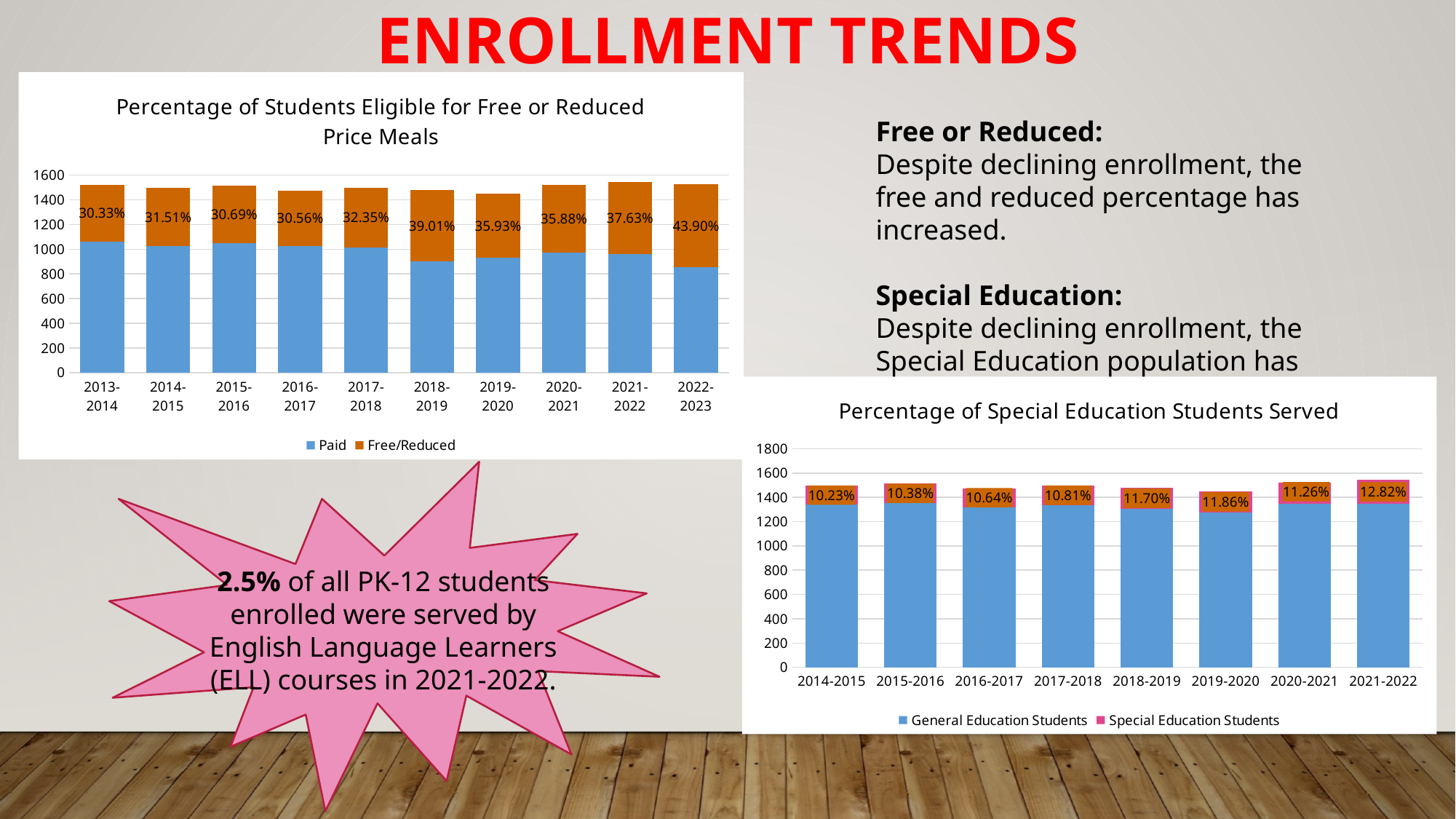
In the chart titled "Percentage of Students Eligible for Free or Reduced Price Meals", which school year has the lowest percentage label? 2013-2014 In the chart titled "Percentage of Students Eligible for Free or Reduced Price Meals", which school year has the highest percentage label? 2022-2023 In the chart titled "Percentage of Students Eligible for Free or Reduced Price Meals", is the total height of the 2021-2022 bar greater or less than 1400? greater In the chart titled "Percentage of Students Eligible for Free or Reduced Price Meals", what percentage label is shown for 2022-2023? 43.90% In the chart titled "Percentage of Special Education Students Served", what percentage label is shown for 2018-2019? 11.70% In the chart titled "Percentage of Students Eligible for Free or Reduced Price Meals", what percentage label is shown for 2013-2014? 30.33% In the chart titled "Percentage of Special Education Students Served", how many series does the legend list? 2 In the chart titled "Percentage of Special Education Students Served", what percentage label is shown for 2021-2022? 12.82% In the chart titled "Percentage of Students Eligible for Free or Reduced Price Meals", what is the difference between the percentage labels for 2022-2023 and 2021-2022? 6.27% In the chart titled "Percentage of Students Eligible for Free or Reduced Price Meals", how many school years are shown on the x axis? 10 In the chart titled "Percentage of Special Education Students Served", which series is larger in every bar, General Education Students or Special Education Students? General Education Students What kind of chart is the chart titled "Percentage of Special Education Students Served"? Stacked bar chart